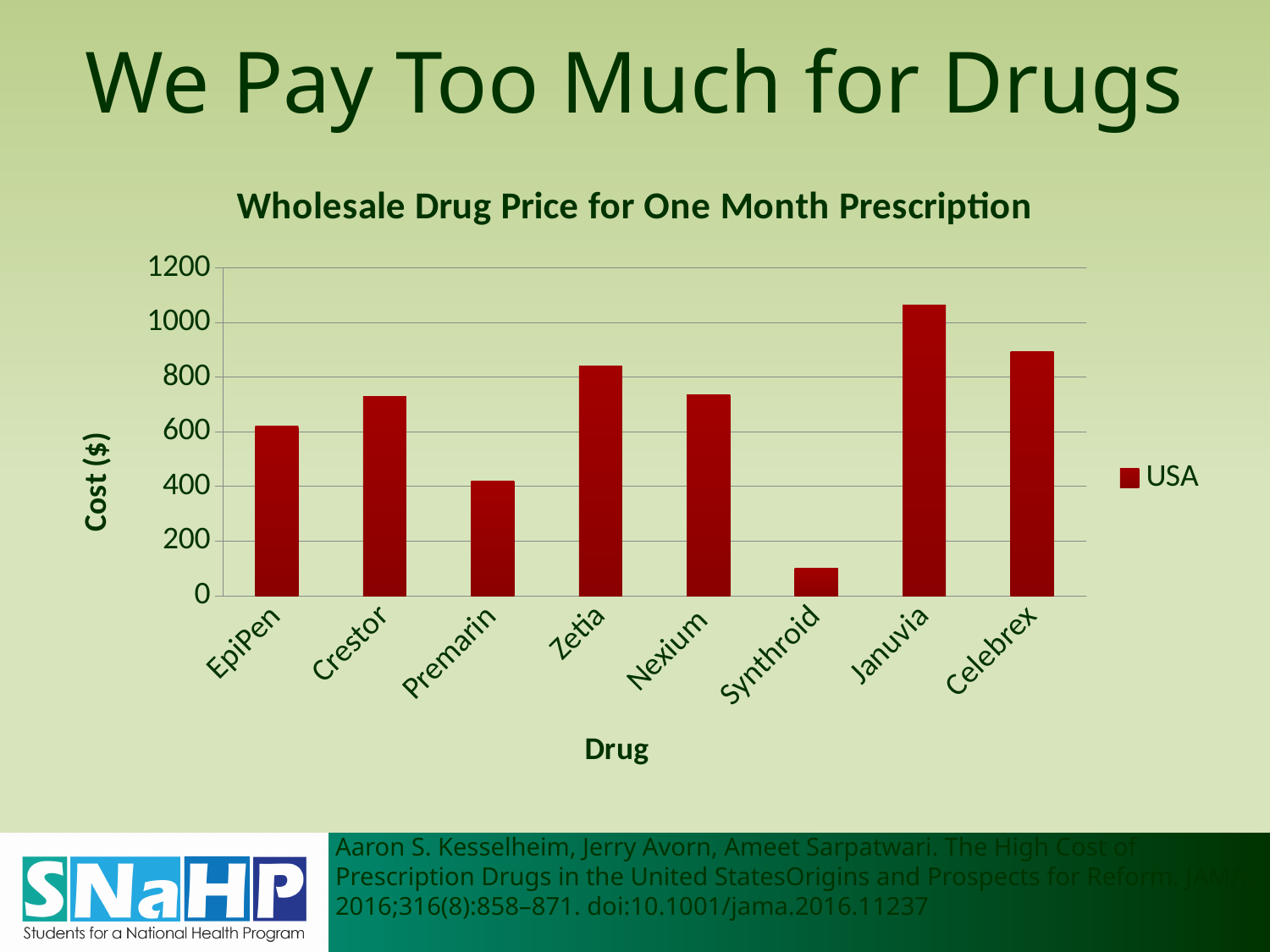
Which drug has the highest wholesale price in the chart? Januvia Which has a higher wholesale price, Premarin or EpiPen? EpiPen Is the value for Zetia greater or less than 800? greater What is the title of the chart? Wholesale Drug Price for One Month Prescription Is the value for Premarin greater or less than 600? less What kind of chart is shown on the slide? Bar chart How many drugs are shown on the x axis of the chart? 8 Which has a higher wholesale price, Zetia or Crestor? Zetia Is the value for Synthroid greater or less than 200? less Which drug has the lowest wholesale price in the chart? Synthroid How many series does the chart's legend list? 1